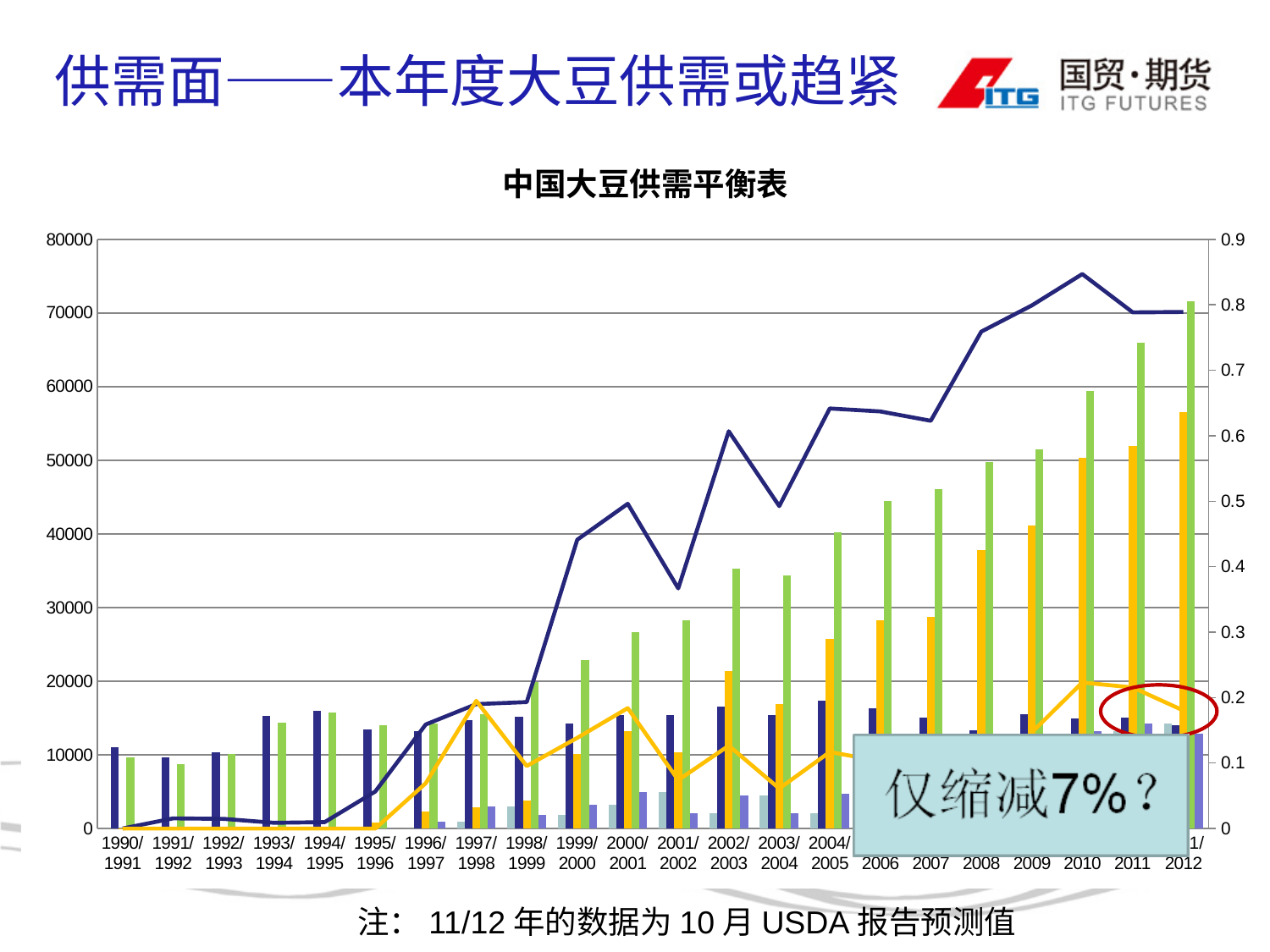
Is the green bar for 2011/2012 greater or less than 60000? greater What kind of chart is shown on the slide? A combined bar and line chart Which year has the tallest green bar? 2011/2012 Is the orange bar for 2011/2012 greater or less than 50000? greater Does the dark blue line generally rise or fall from 1990/1991 to 2011/2012? Rises Is the yellow line's value for 1997/1998 (right axis) greater or less than 0.1? greater According to the note below the chart, what is the source of the 11/12 data? 10 月 USDA 报告预测值 In 2011/2012, which is taller, the green bar or the orange bar? The green bar How many marketing-year categories are shown on the x axis? 22 What is the title of the chart? 中国大豆供需平衡表